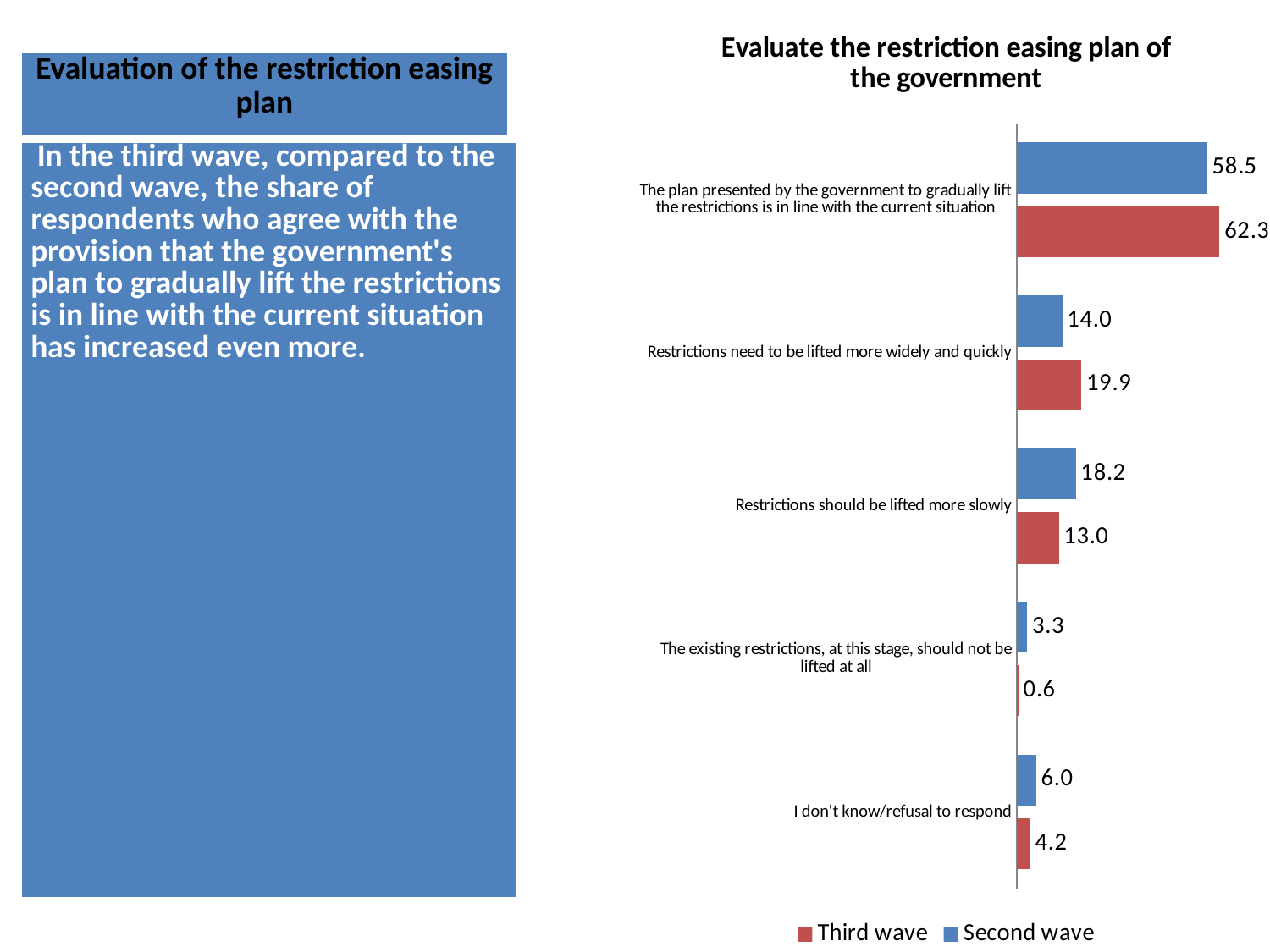
For 'Restrictions should be lifted more slowly', which is larger: the Second wave value or the Third wave value? Second wave What is the Third wave value for 'The plan presented by the government to gradually lift the restrictions is in line with the current situation'? 62.3 What is the difference between the Third wave and Second wave values for 'Restrictions need to be lifted more widely and quickly'? 5.9 What is the Third wave value for 'The existing restrictions, at this stage, should not be lifted at all'? 0.6 What kind of chart is shown on the slide? Bar chart What is the Second wave value for 'I don't know/refusal to respond'? 6.0 Which category has the highest Third wave value? The plan presented by the government to gradually lift the restrictions is in line with the current situation How many categories are shown on the chart? 5 Which category has the lowest Second wave value? The existing restrictions, at this stage, should not be lifted at all How many series does the legend list? 2 What is the title of the chart? Evaluate the restriction easing plan of the government What is the Second wave value for 'Restrictions need to be lifted more widely and quickly'? 14.0